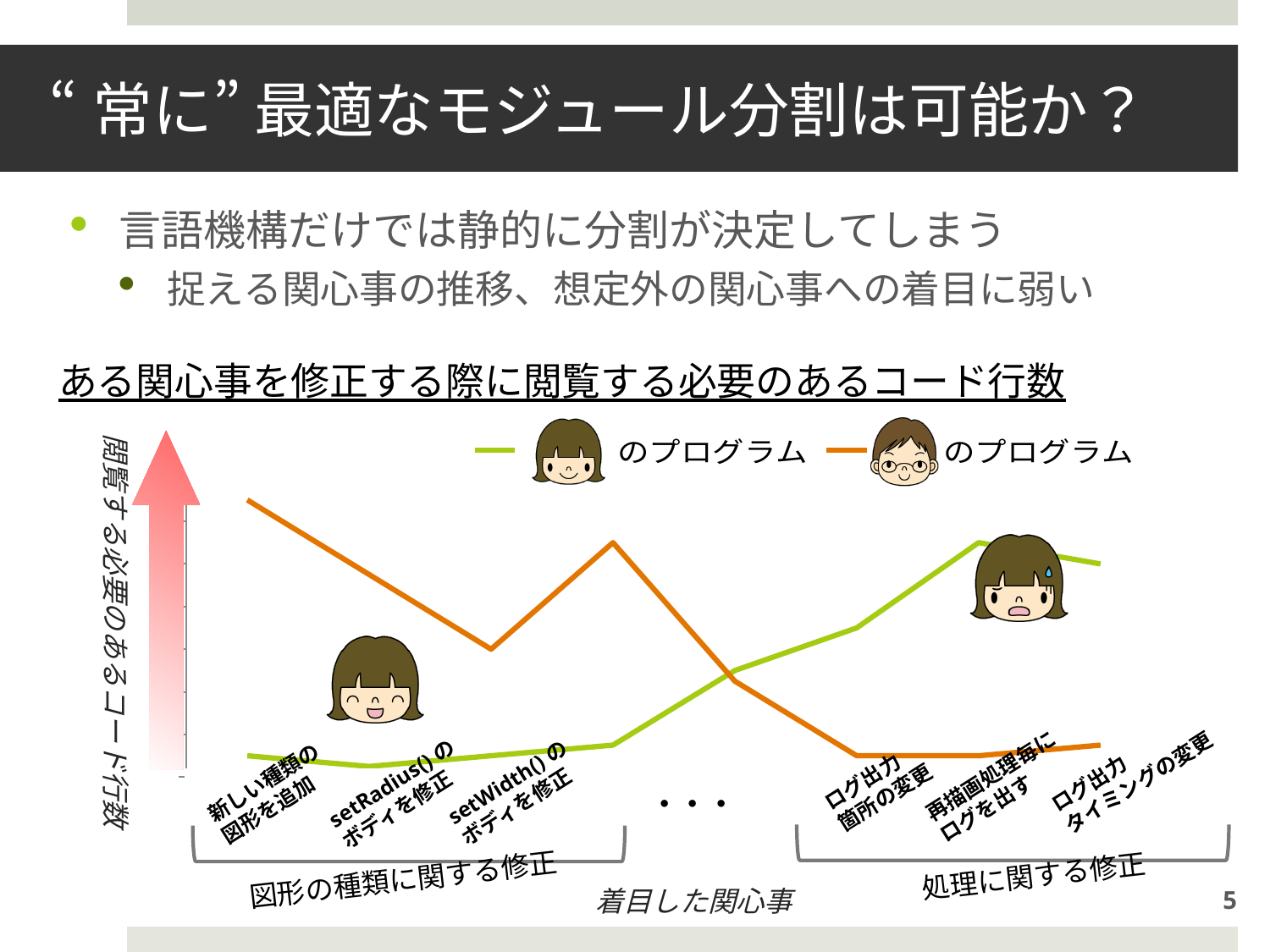
At 新しい種類の図形を追加, which series is higher, the green line or the orange line? the orange line Does the orange line generally rise or fall from left to right across the x axis? fall Between 新しい種類の図形を追加 and setRadius()のボディを修正, does the orange line rise or fall? fall At ログ出力タイミングの変更, which series is higher, the green line or the orange line? the green line At setWidth()のボディを修正, which series is higher, the green line or the orange line? the orange line What is the title of the chart? ある関心事を修正する際に閲覧する必要のあるコード行数 How many labeled categories are shown along the x axis of the chart? 6 How many series does the chart's legend list? 2 What kind of chart is shown on the slide? line chart What is the label of the chart's x axis? 着目した関心事 For the orange line, at which category is the value highest? 新しい種類の図形を追加 Does the green line generally rise or fall from left to right across the x axis? rise